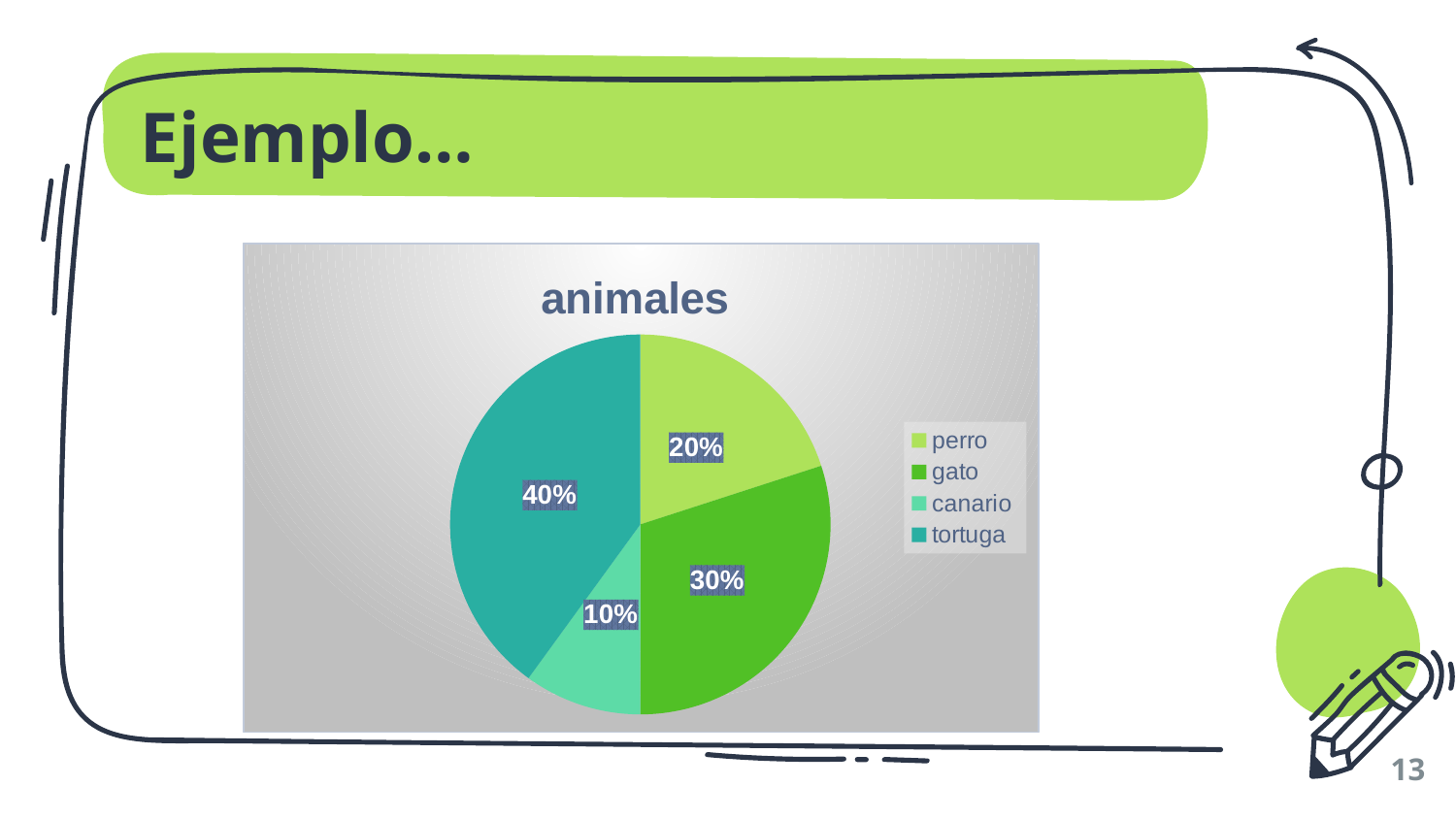
Which is larger, the share for gato or the share for canario? gato Which category has the largest share of the pie? tortuga How many entries does the legend list? 4 What percentage of the pie does canario represent? 10% What type of chart is shown on the slide? pie chart How many categories are shown in the pie chart? 4 What is the difference in percentage points between tortuga and perro? 20 What percentage of the pie does gato represent? 30% What percentage of the pie does perro represent? 20% Which category has the smallest share of the pie? canario What percentage of the pie does tortuga represent? 40% What is the title of the chart? animales